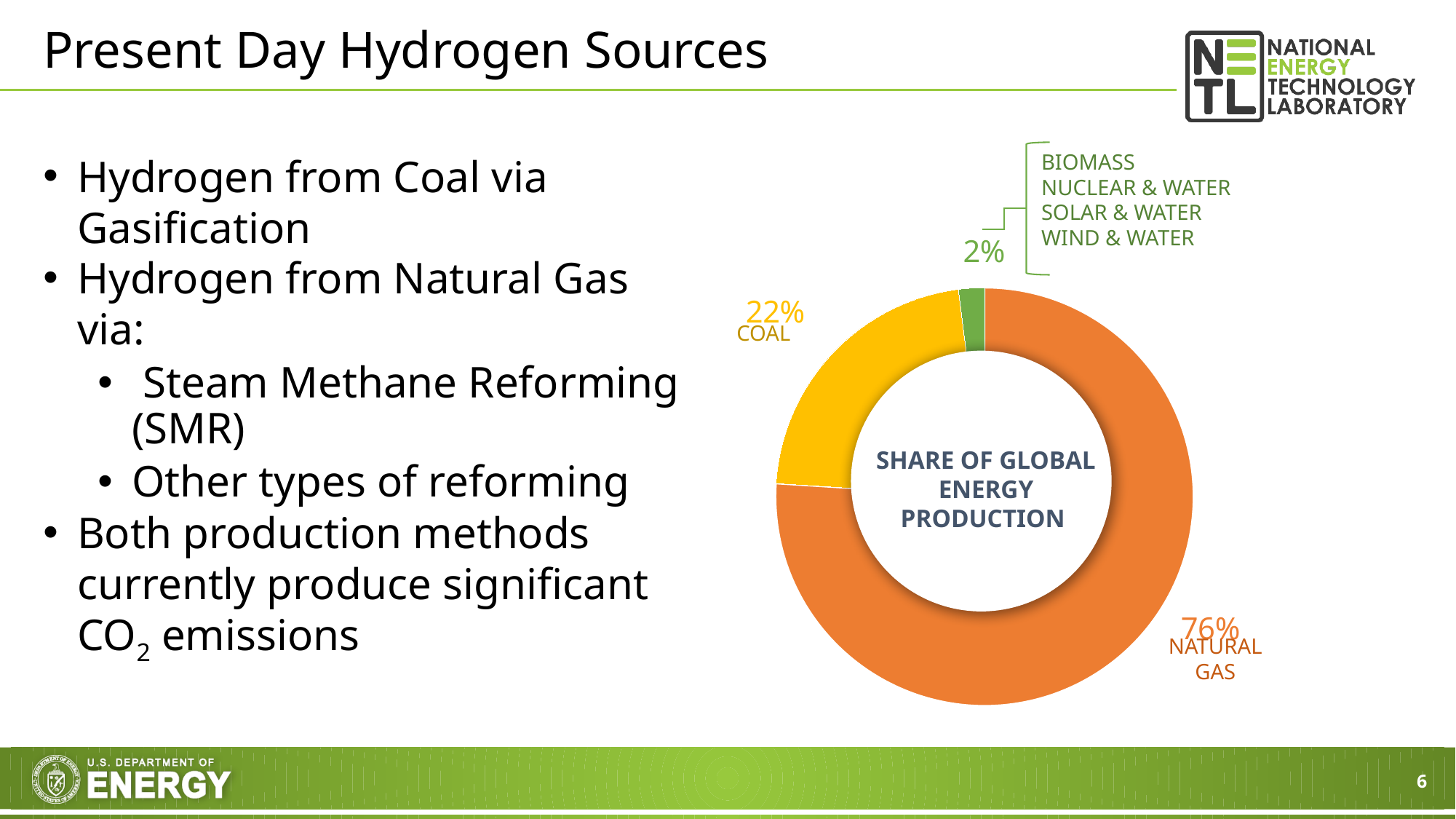
What is the combined share of coal and natural gas in the donut chart? 98% What kind of chart is shown on the slide? Donut (pie) chart How many slices does the donut chart have? 3 What is the title printed in the centre of the donut chart? SHARE OF GLOBAL ENERGY PRODUCTION Which is larger, the share for coal or the share for natural gas? Natural gas Which source has the largest share in the donut chart? Natural gas What is the difference in percentage points between the natural gas share and the coal share? 54 percentage points What share of global energy production does natural gas account for in the donut chart? 76% What colour is the coal slice in the donut chart? Yellow What share is labelled for the green slice (biomass, nuclear & water, solar & water, wind & water)? 2% What share of global energy production does coal account for in the donut chart? 22% Which slice of the donut chart is the smallest? The 2% slice (biomass, nuclear & water, solar & water, wind & water)